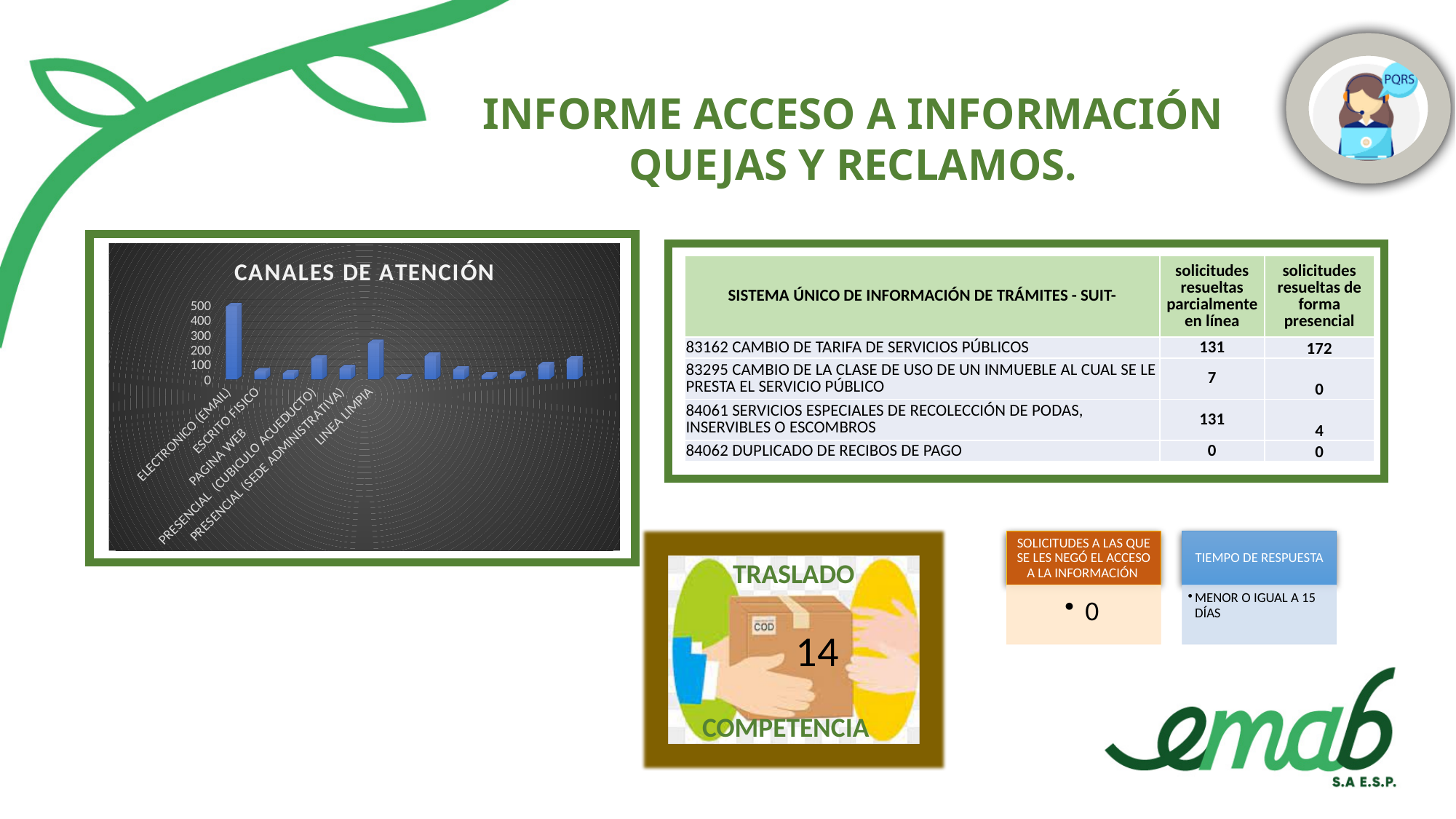
How many bars are plotted in the 'CANALES DE ATENCIÓN' chart? 13 What type of chart is 'CANALES DE ATENCIÓN'? bar chart What is the highest tick value shown on the vertical axis of the 'CANALES DE ATENCIÓN' chart? 500 In the 'CANALES DE ATENCIÓN' chart, is the value for ELECTRONICO (EMAIL) greater or less than 400? greater In the 'CANALES DE ATENCIÓN' chart, which is larger: ELECTRONICO (EMAIL) or PRESENCIAL (SEDE ADMINISTRATIVA)? ELECTRONICO (EMAIL) What is the title of the chart on the left of the slide? CANALES DE ATENCIÓN In the 'CANALES DE ATENCIÓN' chart, is the value for PAGINA WEB greater or less than 300? less In the 'CANALES DE ATENCIÓN' chart, which category has the highest value? ELECTRONICO (EMAIL) In the 'CANALES DE ATENCIÓN' chart, which is larger: ELECTRONICO (EMAIL) or LINEA LIMPIA? ELECTRONICO (EMAIL) In the 'CANALES DE ATENCIÓN' chart, is the value for ESCRITO FISICO greater or less than 300? less